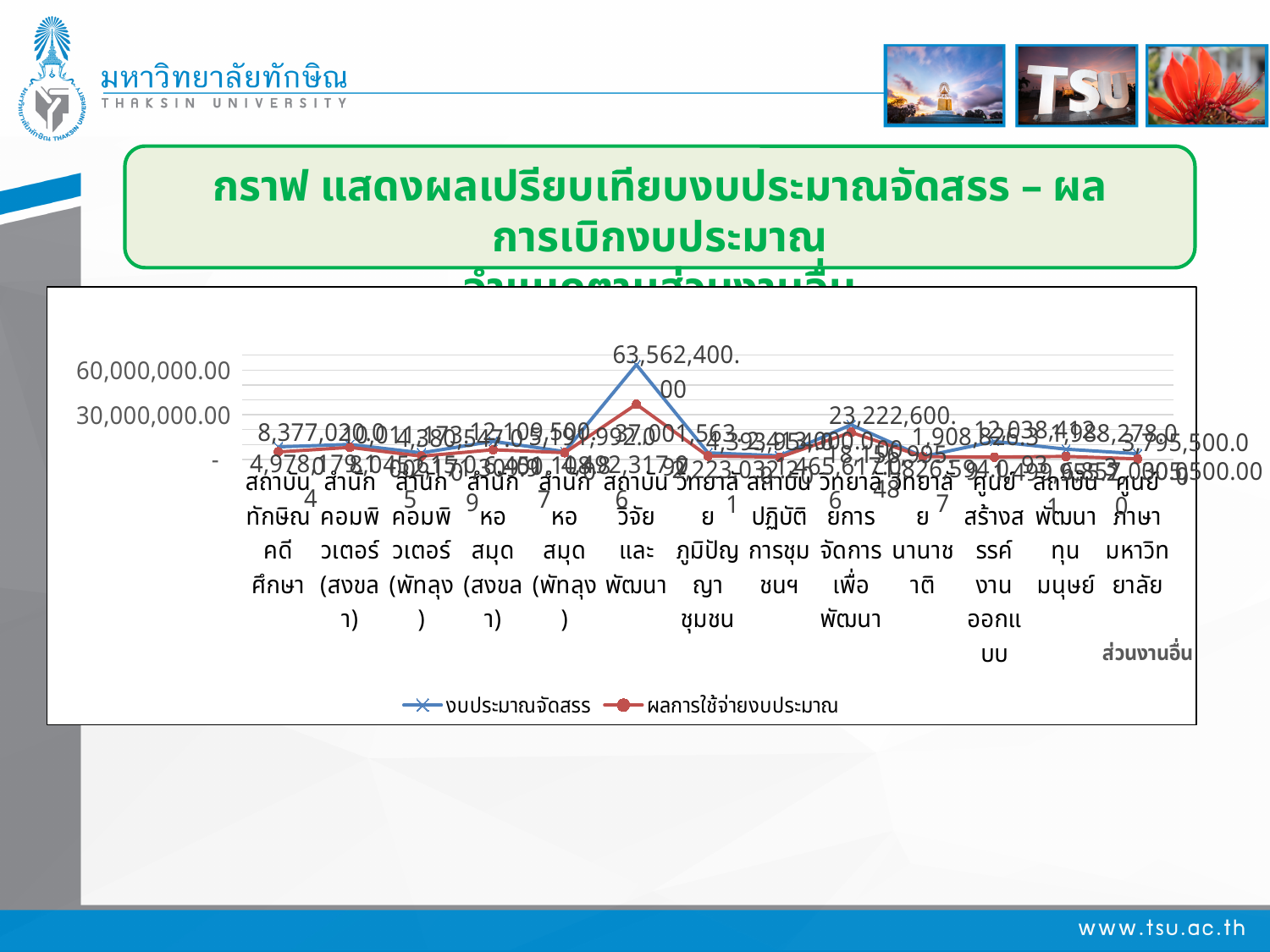
What are the two series named in the legend? งบประมาณจัดสรร and ผลการใช้จ่ายงบประมาณ How many series does the legend list? 2 What kind of chart is shown on the slide? line chart How many units (categories) are plotted along the x axis? 13 Which series is drawn in red with circle markers? ผลการใช้จ่ายงบประมาณ Is the งบประมาณจัดสรร value for สถาบันทักษิณคดีศึกษา greater or less than 30,000,000.00? less Which unit has the highest งบประมาณจัดสรร value? สถาบันวิจัยและพัฒนา